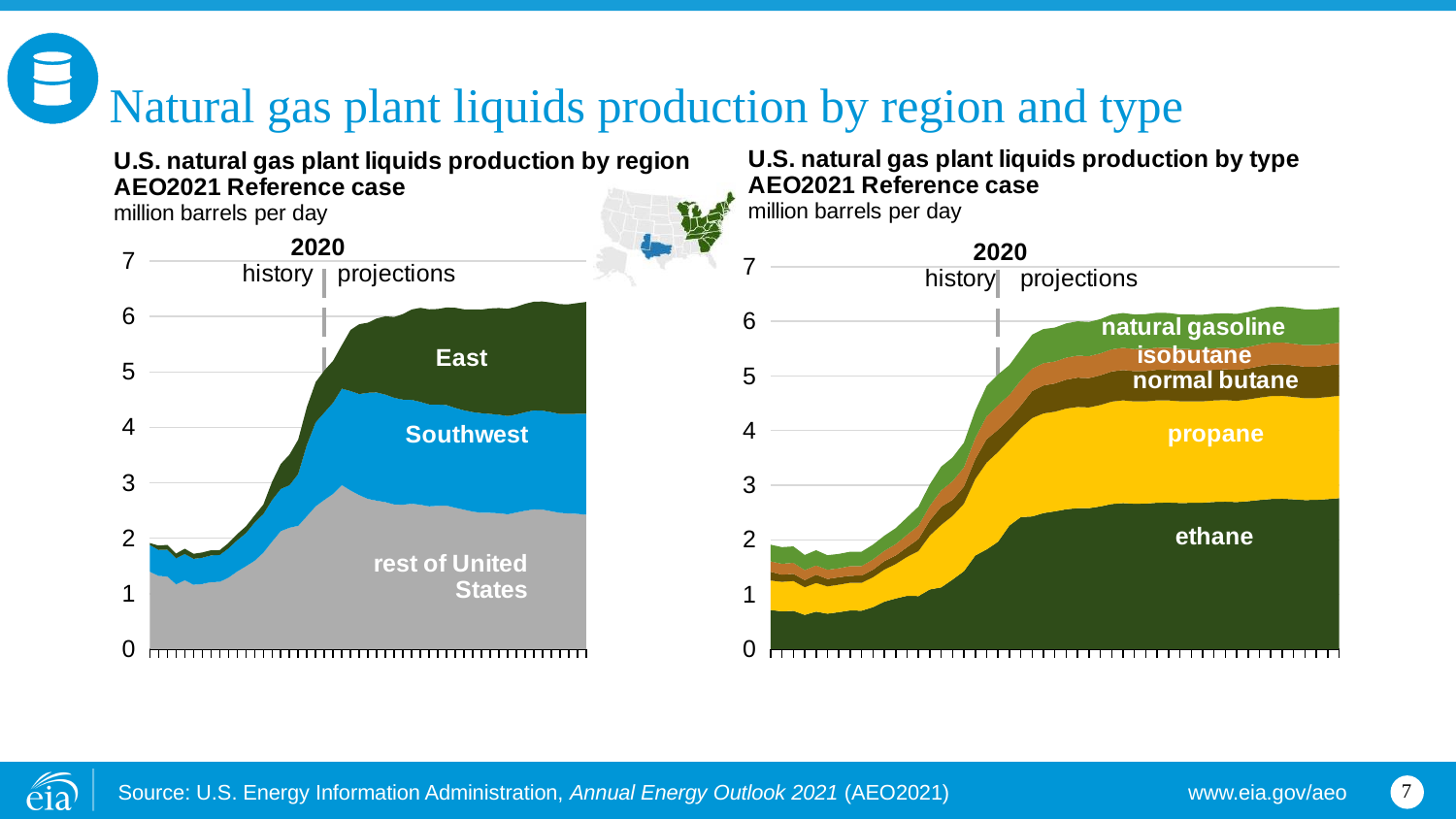
In the left chart (production by region), is the total production at the start of the history period greater or less than 3 million barrels per day? less In the right chart (production by type), which product type has the largest production at the end of the projection period? ethane In the right chart (production by type), is ethane production at the end of the projection period greater or less than 2 million barrels per day? greater In the left chart (production by region), is the total production at the end of the projection period greater or less than 6 million barrels per day? greater What year does the vertical dashed line separating history from projections mark in both charts? 2020 In the left chart (production by region), which region has the largest production at the end of the projection period? rest of United States What kind of chart is the 'U.S. natural gas plant liquids production by region' chart on the left? stacked area chart How many regions are shown as series in the left chart, 'U.S. natural gas plant liquids production by region'? 3 What unit is used on the y axis of both charts? million barrels per day How many product types are shown as series in the right chart, 'U.S. natural gas plant liquids production by type'? 5 In the right chart (production by type), does total production rise or fall over the history period leading up to 2020? rise